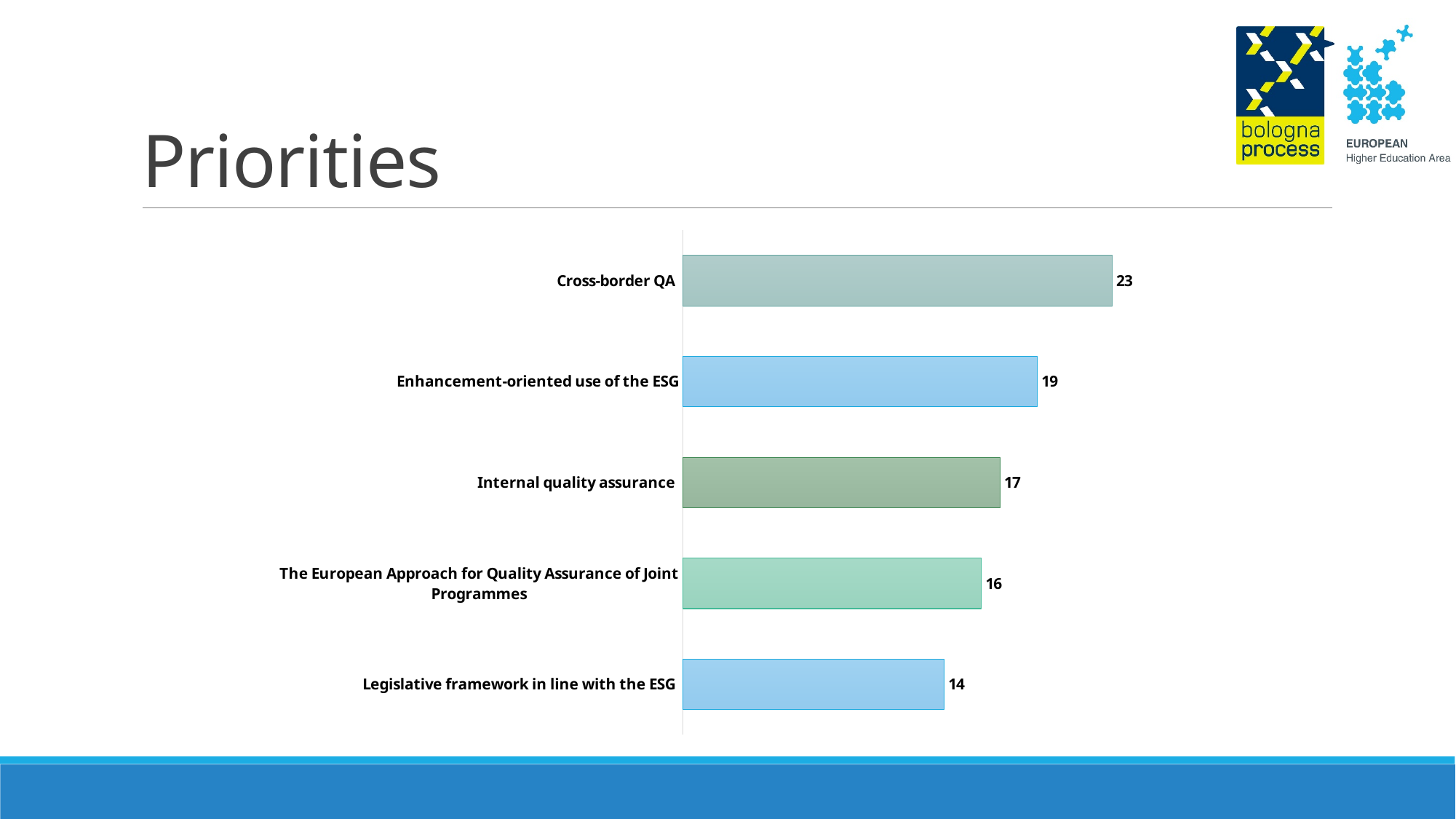
Which is larger: the value for Internal quality assurance or the value for The European Approach for Quality Assurance of Joint Programmes? Internal quality assurance What is the value for The European Approach for Quality Assurance of Joint Programmes? 16 Which category has the lowest value? Legislative framework in line with the ESG How many categories are shown in the chart? 5 What is the difference between the values for Cross-border QA and Legislative framework in line with the ESG? 9 What kind of chart is shown on the slide? Bar chart What is the value for Legislative framework in line with the ESG? 14 Which category has the highest value? Cross-border QA What is the value for Cross-border QA? 23 What is the value for Internal quality assurance? 17 What is the value for Enhancement-oriented use of the ESG? 19 What is the difference between the values for Enhancement-oriented use of the ESG and Internal quality assurance? 2